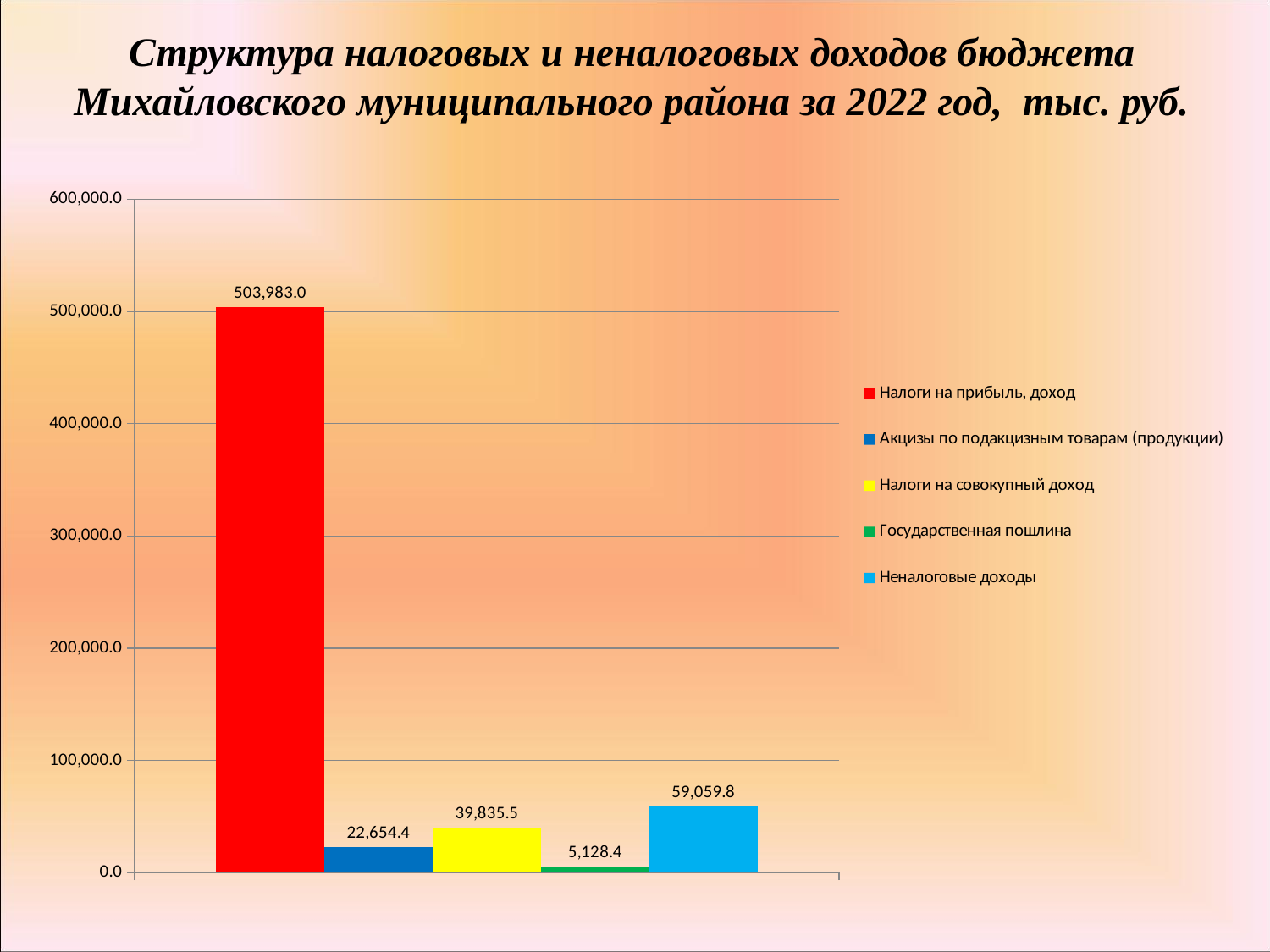
Is the value for Налоги на прибыль, доход greater or less than 500,000.0? greater What is the value for Государственная пошлина? 5,128.4 Which category has the lowest value? Государственная пошлина What is the value for Акцизы по подакцизным товарам (продукции)? 22,654.4 How many series does the legend list? 5 Which category has the highest value? Налоги на прибыль, доход What is the value for Неналоговые доходы? 59,059.8 What is the difference between Неналоговые доходы and Налоги на совокупный доход? 19,224.3 What is the value for Налоги на прибыль, доход? 503,983.0 Which is larger: Налоги на совокупный доход or Акцизы по подакцизным товарам (продукции)? Налоги на совокупный доход What colour is the bar for Неналоговые доходы? light blue What kind of chart is shown on the slide? bar chart